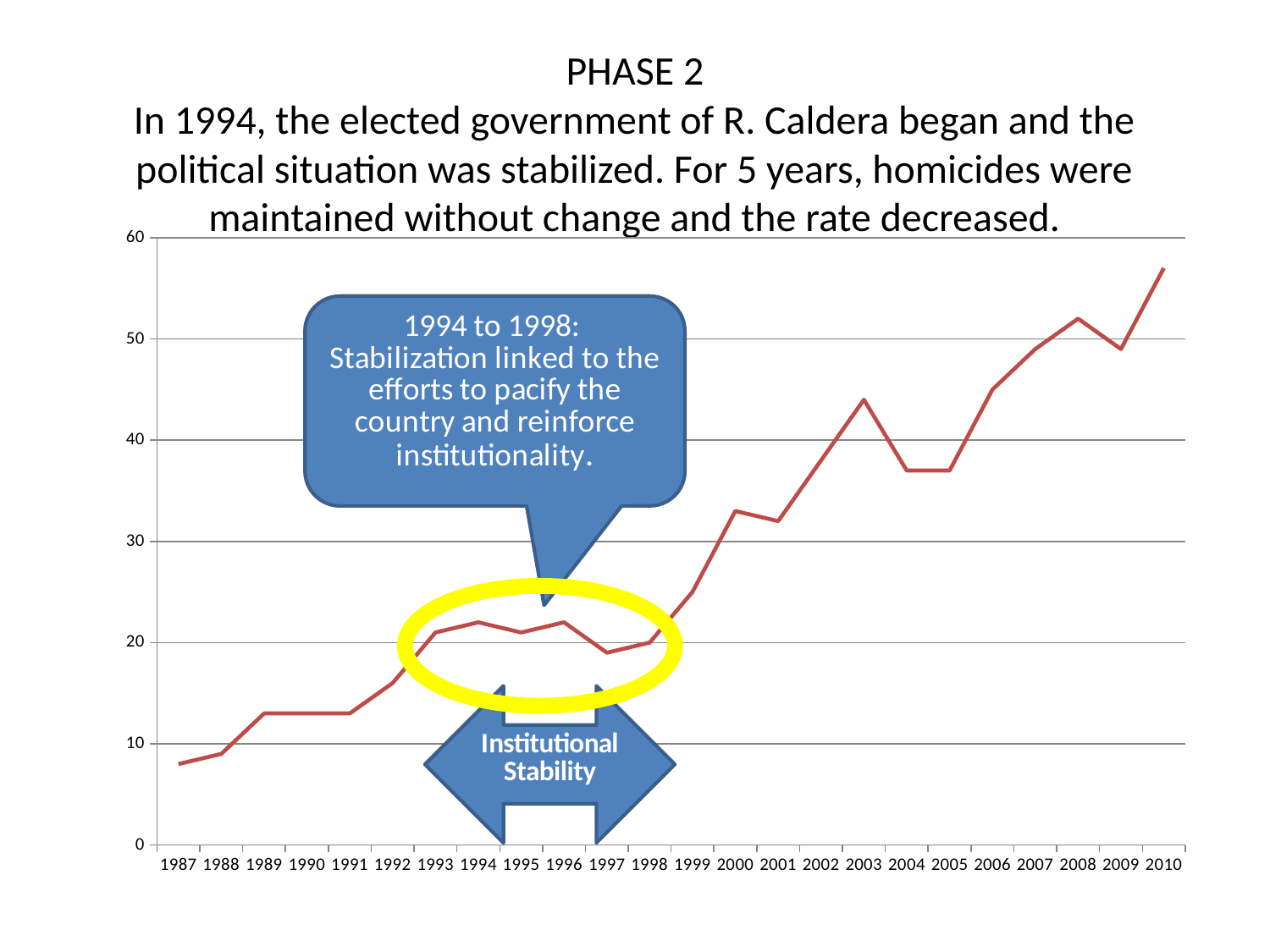
Which year has the larger value, 2003 or 2004? 2003 How many years are plotted along the x axis of the chart? 24 What kind of chart is shown on the slide? line chart Is the value for 2004 greater or less than 40? less What label is written on the double-headed arrow below the highlighted section of the line? Institutional Stability Which year has the larger value, 2008 or 2010? 2010 Is the value for 2003 greater or less than 40? greater Which year has the highest value on the chart? 2010 Overall, do the values rise or fall from 1987 to 2010? rise Is the value for 2010 greater or less than 50? greater Which year has the lowest value on the chart? 1987